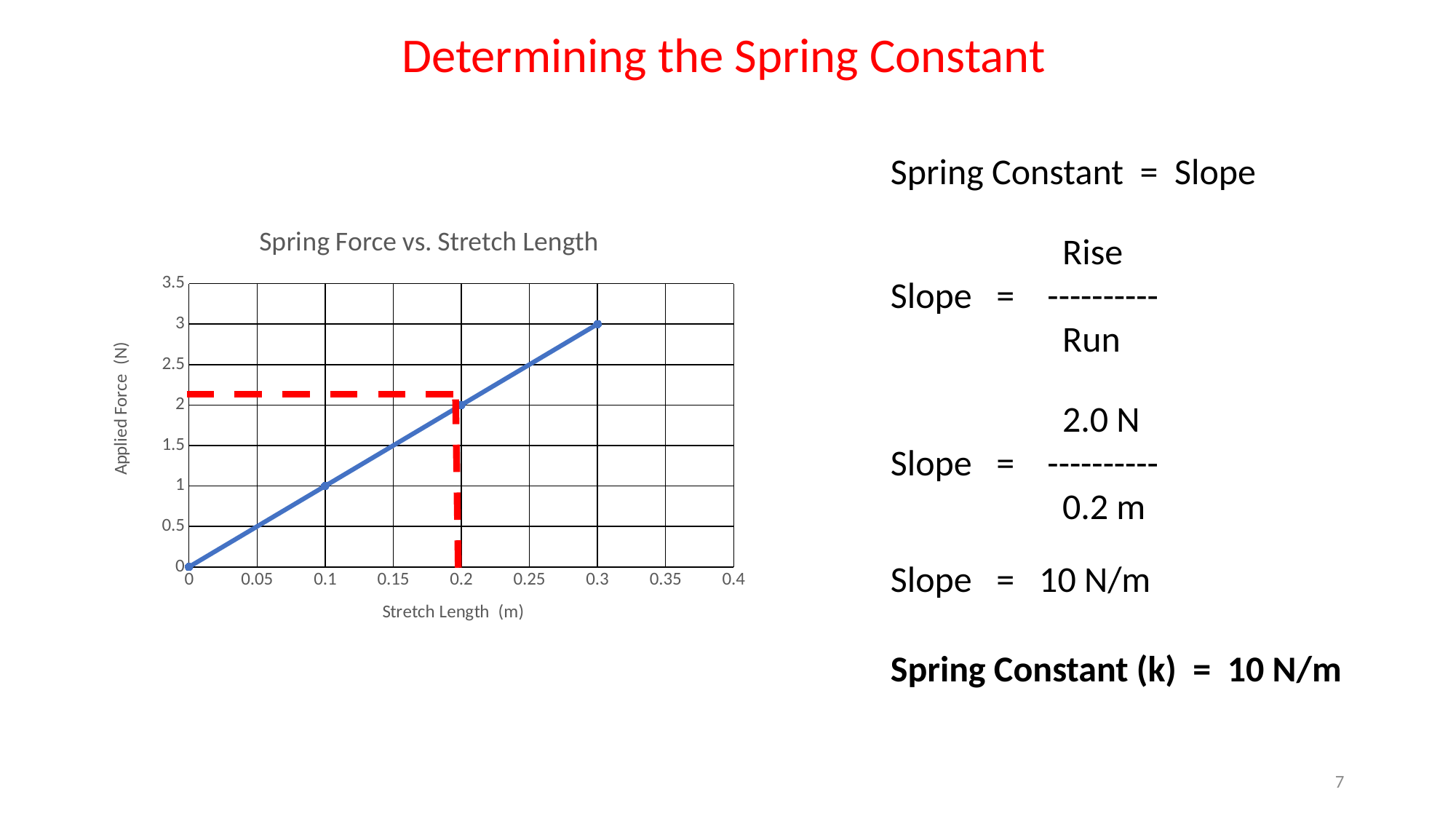
At which stretch length is the applied force highest? 0.3 At which stretch length is the applied force lowest? 0 Which has a larger applied force: a stretch length of 0.2 m or 0.1 m? 0.2 m What kind of chart is shown on the slide? line chart What is the label of the y axis? Applied Force (N) What is the applied force at a stretch length of 0.2 m? 2 How many data points are plotted on the chart? 4 Does the applied force rise or fall as stretch length increases? rise What is the applied force at a stretch length of 0.3 m? 3 What is the difference in applied force between stretch lengths of 0.3 m and 0.1 m? 2 What is the title of the chart? Spring Force vs. Stretch Length What is the applied force at a stretch length of 0.1 m? 1